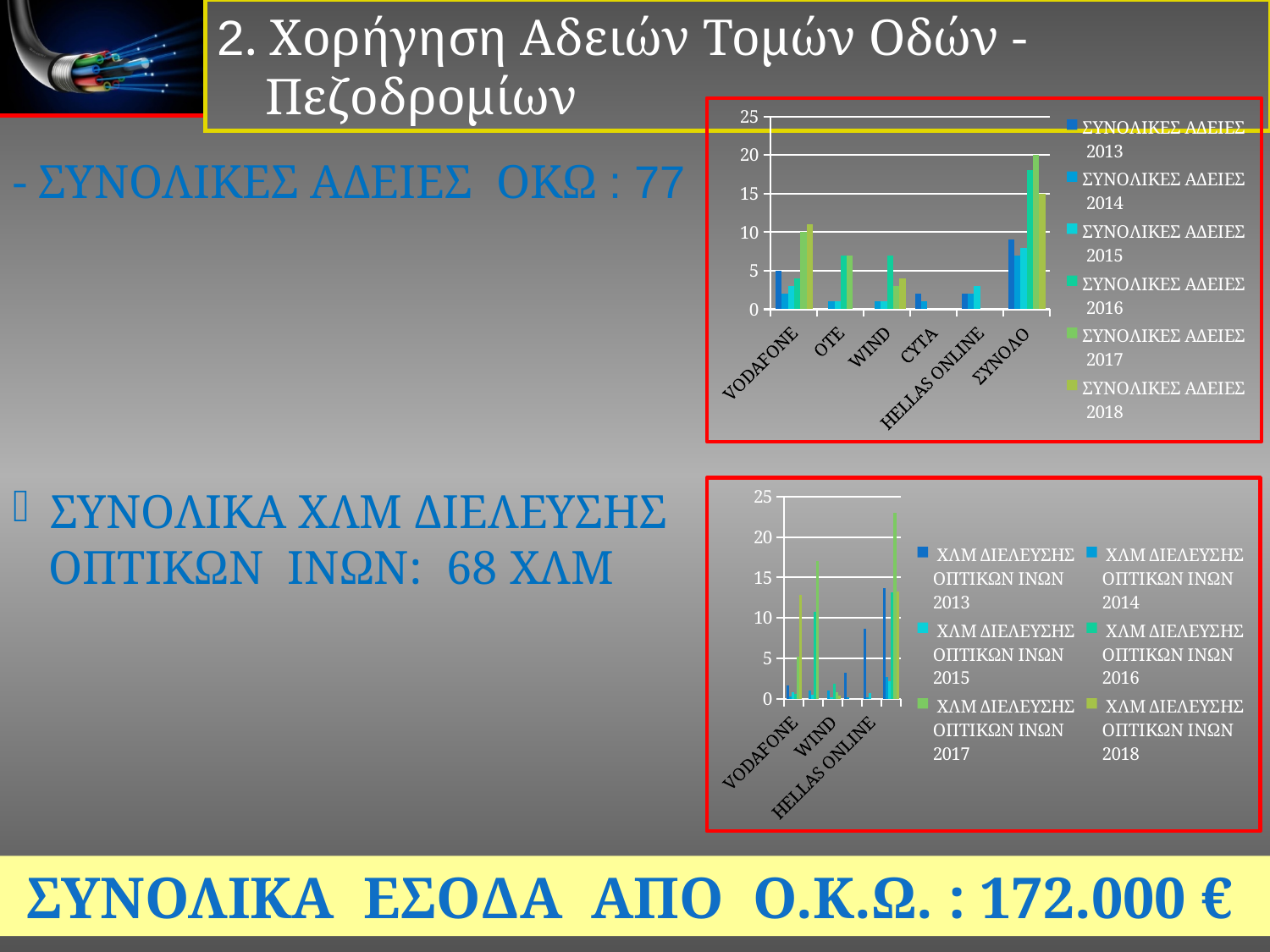
How many series does the legend of the top chart list? 6 In the top chart, which is larger for ΣΥΝΟΛΙΚΕΣ ΑΔΕΙΕΣ 2018: VODAFONE or OTE? VODAFONE What kind of chart is the top chart on the slide? bar chart How many categories are shown on the x axis of the top chart? 6 In the top chart, is the value for OTE in ΣΥΝΟΛΙΚΕΣ ΑΔΕΙΕΣ 2016 greater or less than 5? greater How many series does the legend of the bottom chart list? 6 In the top chart, which category has the tallest bars overall? ΣΥΝΟΛΟ